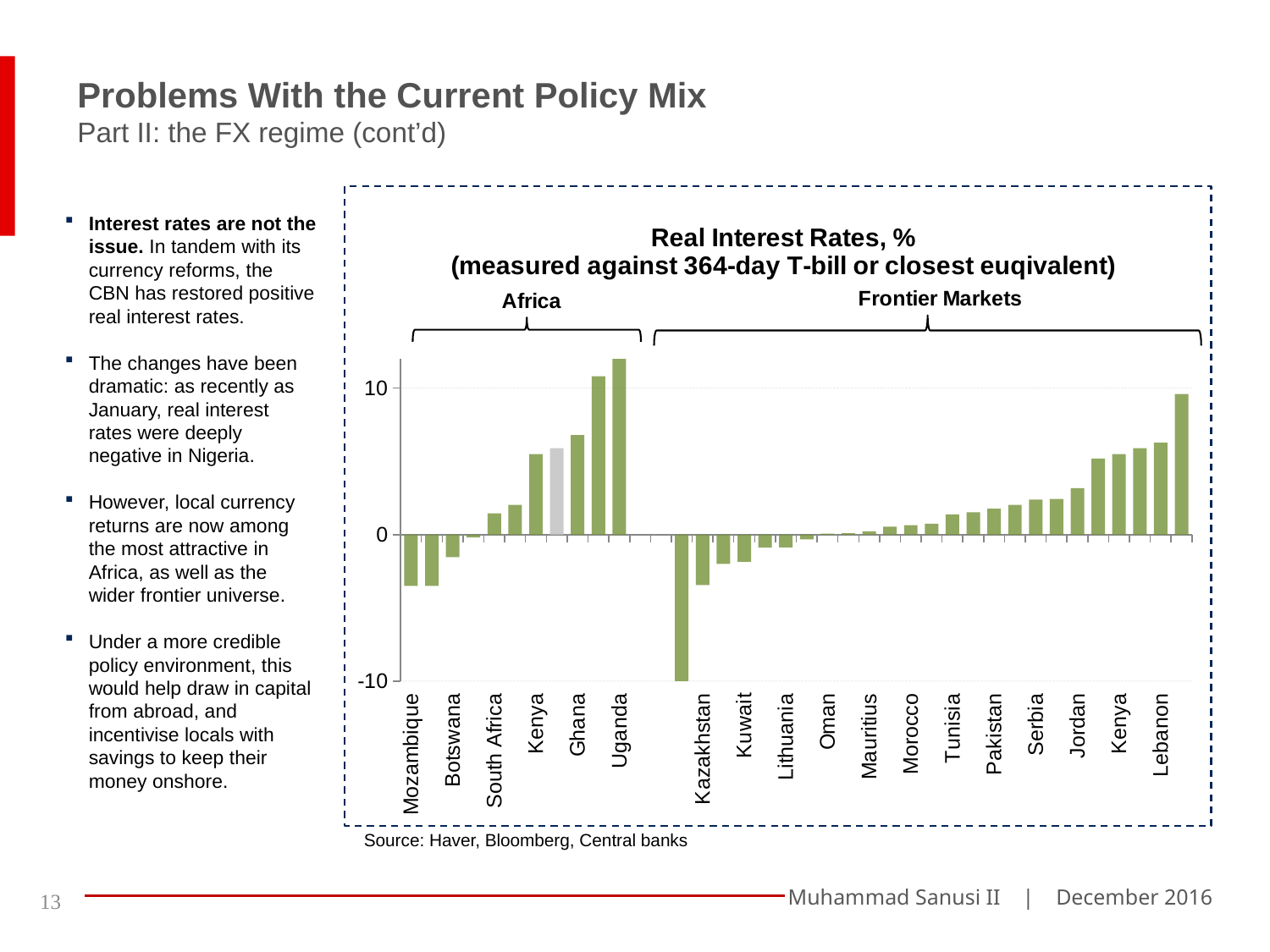
Is the value for Kazakhstan greater or less than -5? greater Which has the higher real interest rate, Uganda or Lebanon? Uganda What is the title of the chart? Real Interest Rates, % Is the value for Mozambique greater or less than 0? less Is the value for Lebanon greater or less than 5? greater What kind of chart is shown on the slide? Bar chart Which two groups of countries are labelled above the chart? Africa and Frontier Markets Which country has the highest real interest rate in the chart? Uganda Within the Frontier Markets group, do the bars rise or fall from left to right? Rise